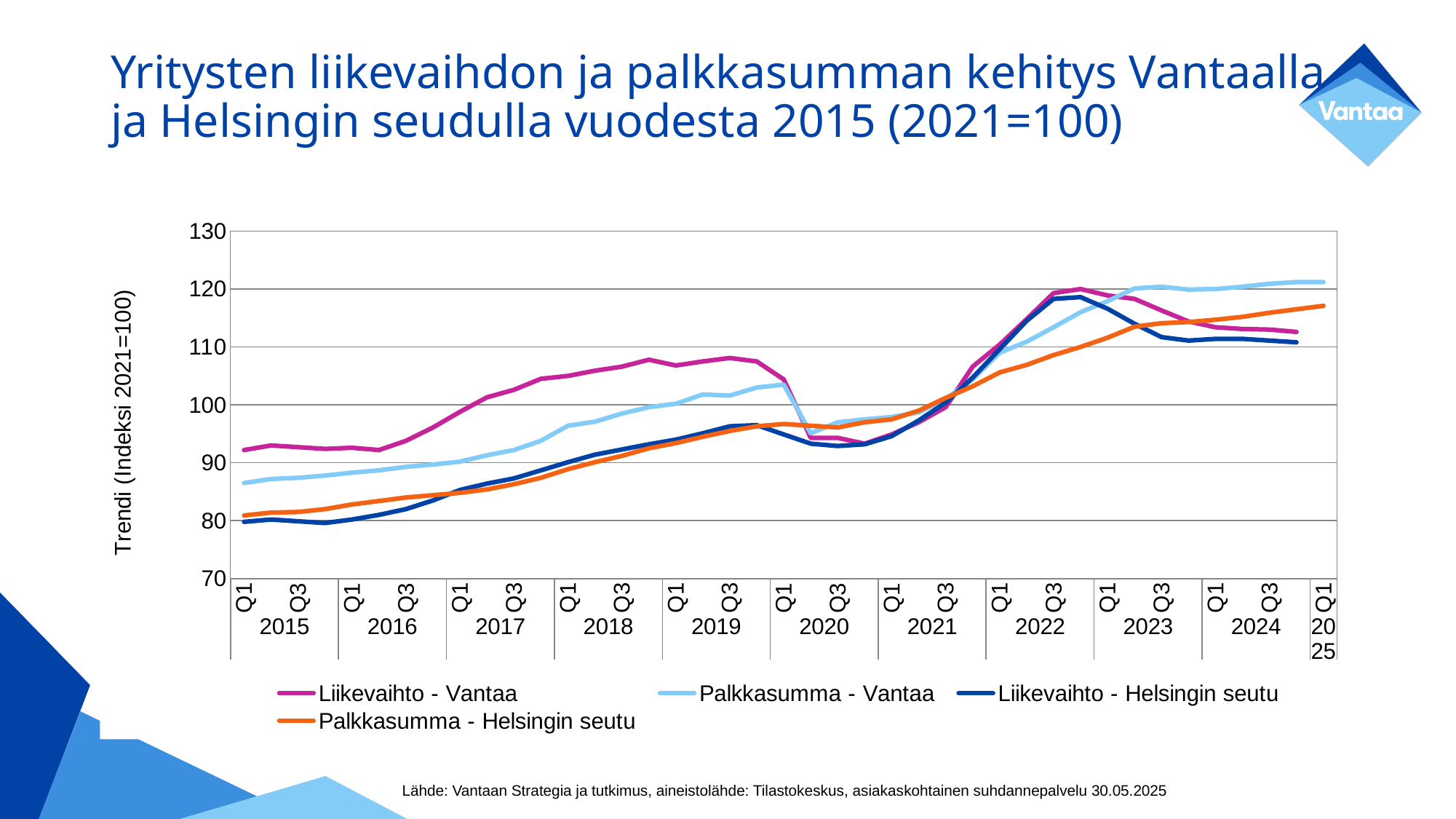
How many series does the legend list? 4 Which year labels appear on the horizontal axis, from first to last? 2015 to 2025 Is the value for Palkkasumma - Vantaa at Q1 2025 greater or less than 120? greater What kind of chart is shown on the slide? line chart Is the value for Palkkasumma - Vantaa at Q1 2015 greater or less than 90? less Is the value for Palkkasumma - Helsingin seutu at Q1 2025 greater or less than 120? less What is the label of the vertical axis? Trendi (Indeksi 2021=100) Which series has the highest value at Q1 2025? Palkkasumma - Vantaa At Q1 2015, which is larger: Liikevaihto - Vantaa or Palkkasumma - Vantaa? Liikevaihto - Vantaa